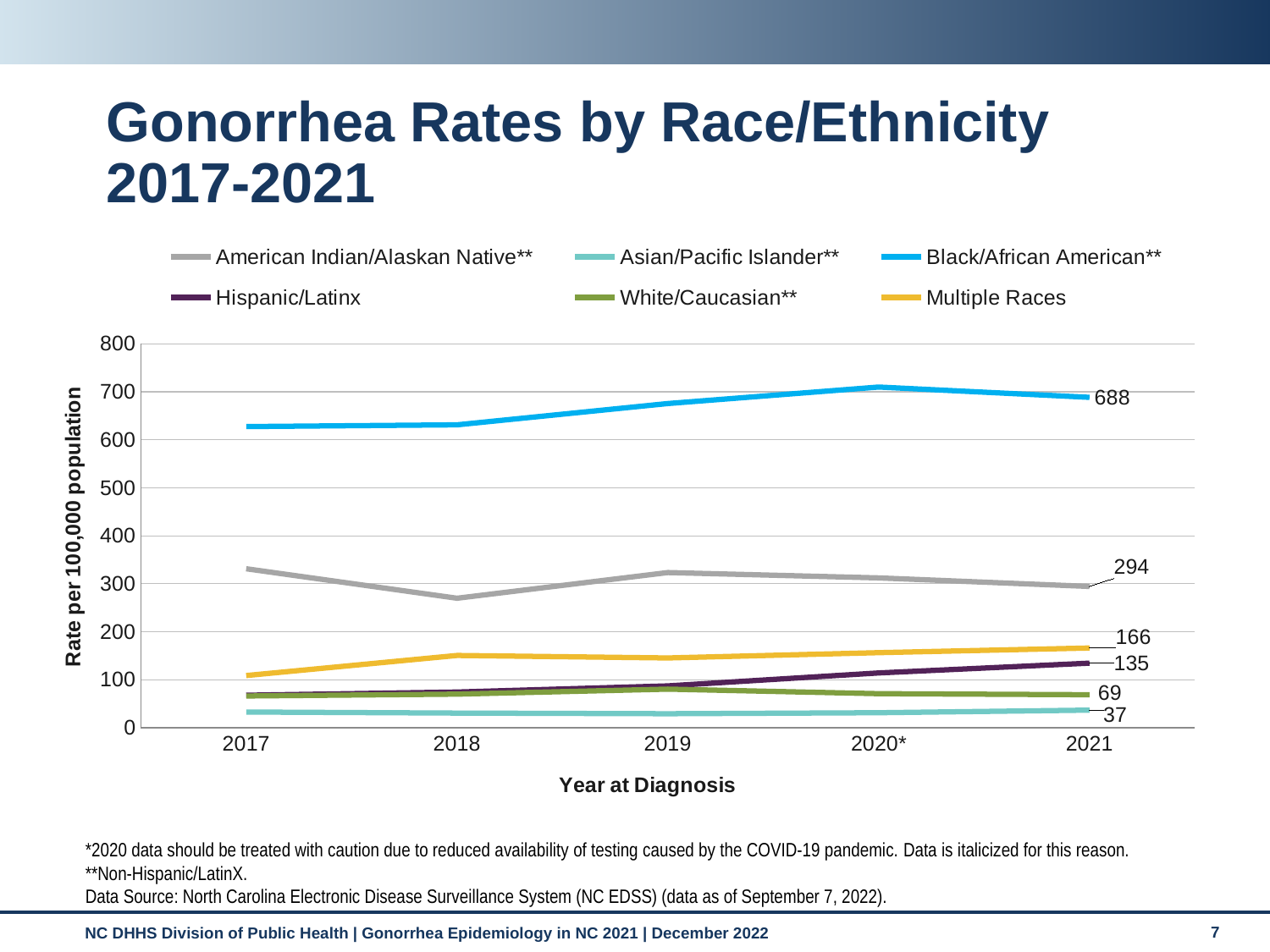
How many series does the legend list? 6 Which race/ethnicity has the lowest rate in 2021? Asian/Pacific Islander Does the Hispanic/Latinx rate rise or fall from 2017 to 2021? rise What type of chart is shown on the slide? line chart How many years are shown on the x axis? 5 Is the rate for Black/African American in 2017 greater or less than 600? greater What is the 2021 gonorrhea rate for Black/African American? 688 What is the 2021 gonorrhea rate for American Indian/Alaskan Native? 294 Which race/ethnicity has the highest rate in 2021? Black/African American What is the 2021 gonorrhea rate for Multiple Races? 166 What is the 2021 gonorrhea rate for Asian/Pacific Islander? 37 What is the difference between the 2021 rates for Multiple Races and Hispanic/Latinx? 31